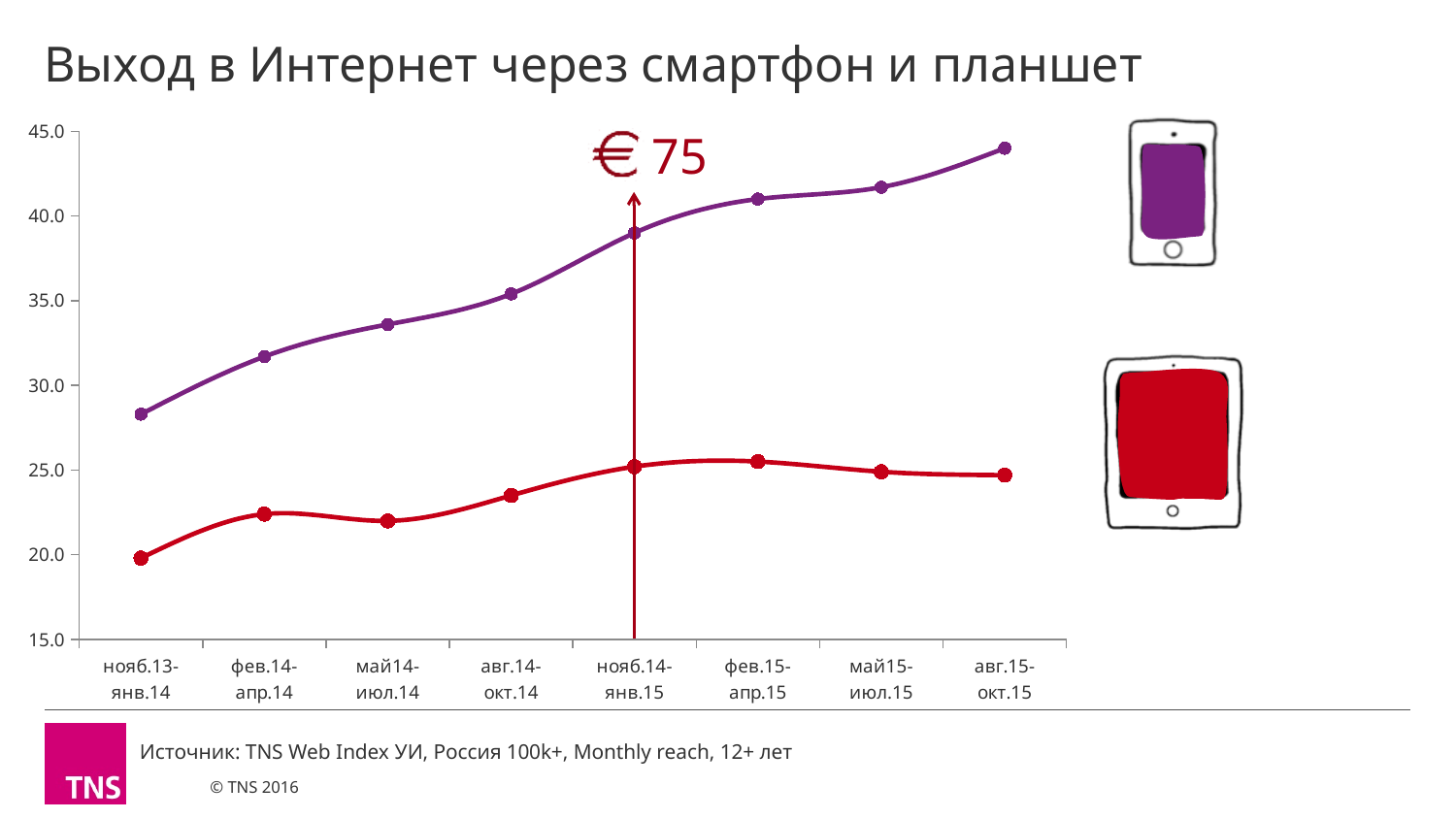
Is the value of the purple line for авг.15-окт.15 greater or less than 40? greater What is the title of the chart? Выход в Интернет через смартфон и планшет In which period does the red line have its lowest value? ноя.13-янв.14 In which period does the purple line reach its highest value? авг.15-окт.15 Is the value of the purple line for ноя.14-янв.15 greater or less than 35? greater Is the value of the purple line for ноя.13-янв.14 greater or less than 30? less How many lines are plotted on the chart? 2 What kind of chart is shown on the slide? line chart Does the purple line rise or fall from ноя.13-янв.14 to авг.15-окт.15? rises How many time periods are plotted along the x axis? 8 Which line has the higher value for май15-июл.15, the purple line or the red line? the purple line